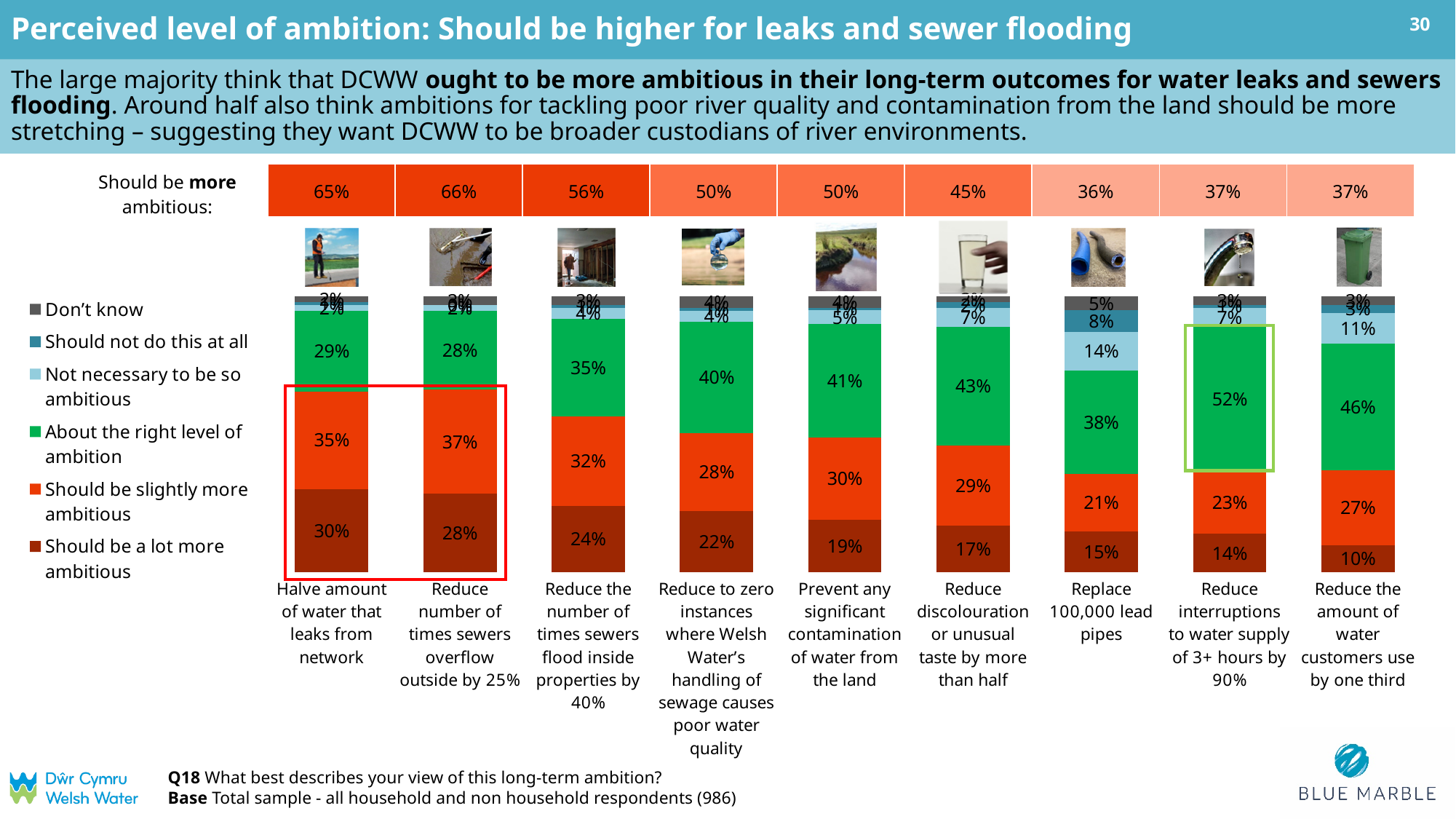
Which ambition has the highest share of 'Should be a lot more ambitious'? Halve amount of water that leaks from network How many long-term ambitions (categories) are plotted along the x axis? 9 Which has a larger 'Should be a lot more ambitious' share: 'Reduce the number of times sewers flood inside properties by 40%' or 'Reduce to zero instances where Welsh Water's handling of sewage causes poor water quality'? Reduce the number of times sewers flood inside properties by 40% What percentage said 'About the right level of ambition' for 'Reduce interruptions to water supply of 3+ hours by 90%'? 52% What is the difference in 'Should be slightly more ambitious' between 'Reduce number of times sewers overflow outside by 25%' and 'Halve amount of water that leaks from network'? 2 percentage points What kind of chart is shown on the slide? Stacked bar chart What percentage said 'Should be a lot more ambitious' for 'Halve amount of water that leaks from network'? 30% How many series does the legend list? 6 Which two bars are outlined with a red box on the chart? Halve amount of water that leaks from network and Reduce number of times sewers overflow outside by 25% What is the combined 'Should be more ambitious' total (a lot more plus slightly more) shown for 'Replace 100,000 lead pipes'? 36% Which ambition has the lowest share of 'Should be a lot more ambitious'? Reduce the amount of water customers use by one third What percentage said 'Not necessary to be so ambitious' for 'Replace 100,000 lead pipes'? 14%